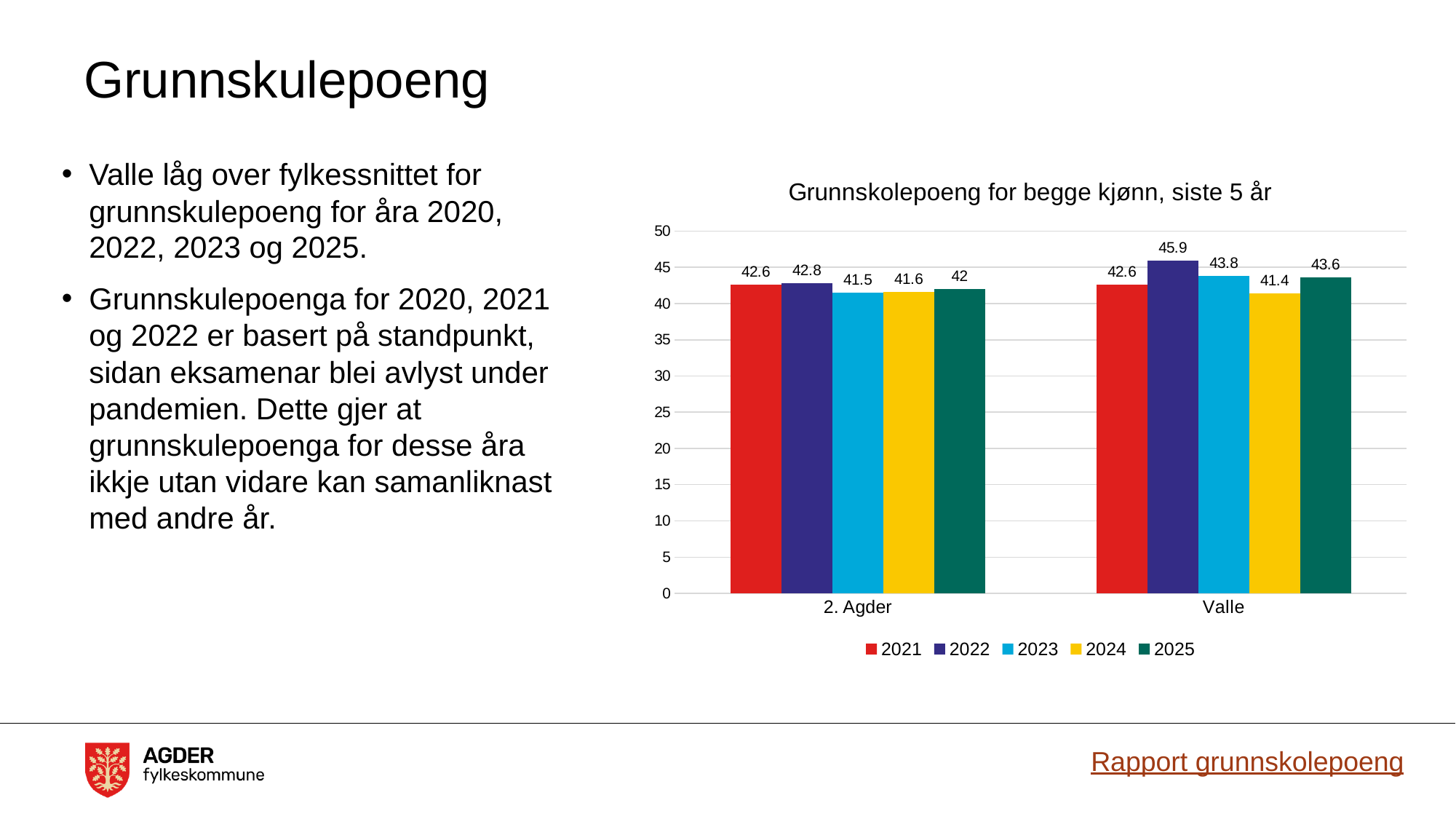
What is the difference between Valle and 2. Agder in 2022? 3.1 What is the title of the chart? Grunnskolepoeng for begge kjønn, siste 5 år Which year has the lowest value for 2. Agder? 2023 Is the value for Valle in 2022 greater or less than 45? greater What kind of chart is shown on the slide? Bar chart What is the value for 2. Agder in 2025? 42 Which year has the highest value for Valle? 2022 What is the value for 2. Agder in 2023? 41.5 Which is larger in 2025, the value for Valle or for 2. Agder? Valle How many series does the legend list? 5 What is the value for Valle in 2024? 41.4 What is the value for Valle in 2022? 45.9